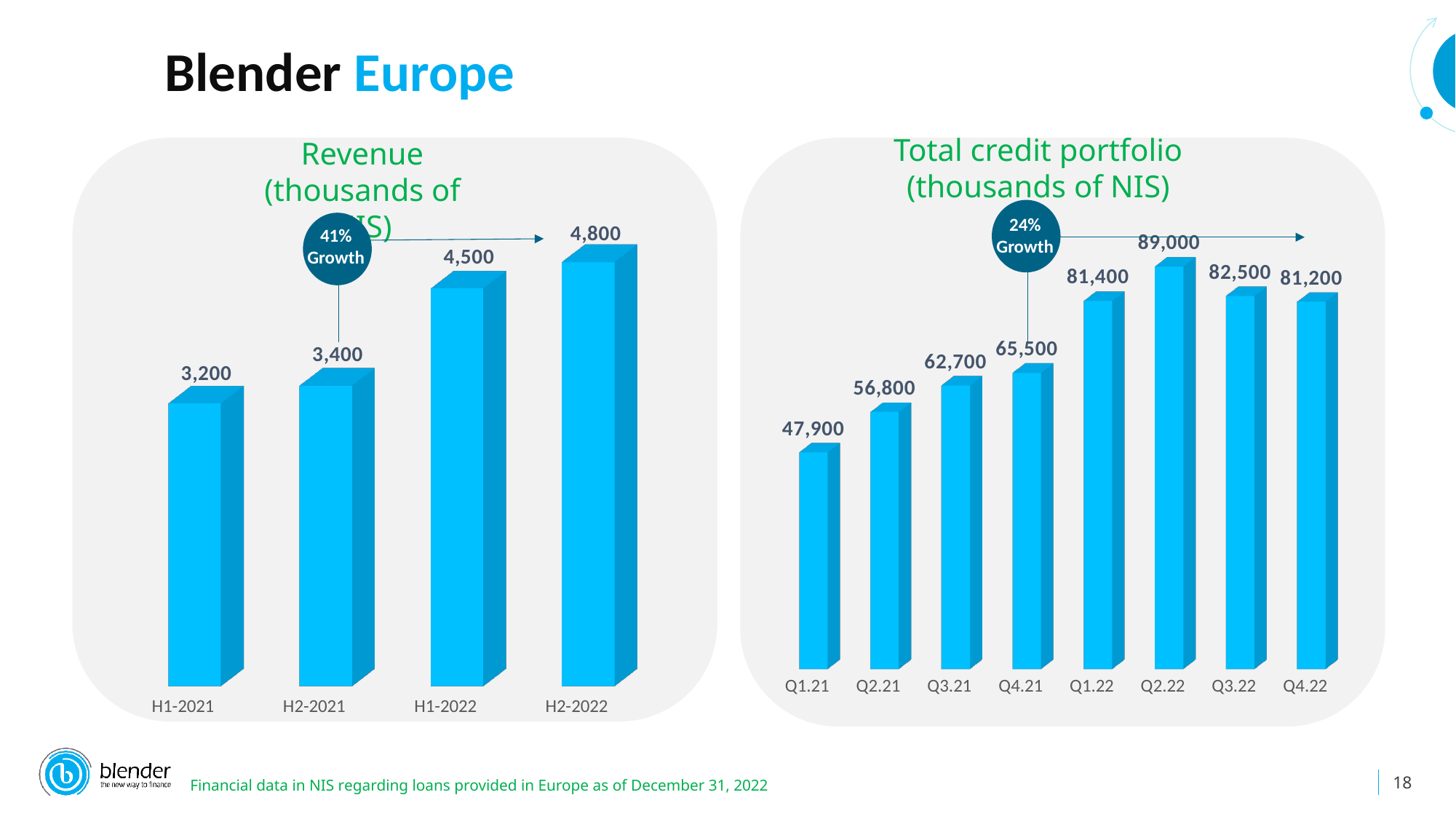
In the Revenue chart, how many periods are shown? 4 In the Total credit portfolio chart, which quarter has the lowest value? Q1.21 In the Revenue chart, what is the value for H1-2022? 4,500 In the Total credit portfolio chart, what is the difference between Q2.22 and Q1.22? 7,600 In the Revenue chart, which period has the lowest value? H1-2021 In the Revenue chart, which period has the highest value? H2-2022 In the Total credit portfolio chart, which quarter has the highest value? Q2.22 In the Revenue chart, what is the difference between H2-2022 and H1-2021? 1,600 What type of chart is the Total credit portfolio chart? bar chart In the Total credit portfolio chart, what is the value for Q3.21? 62,700 In the Revenue chart, do the values rise or fall from H1-2021 to H2-2022? rise In the Total credit portfolio chart, which is larger, Q3.22 or Q4.22? Q3.22